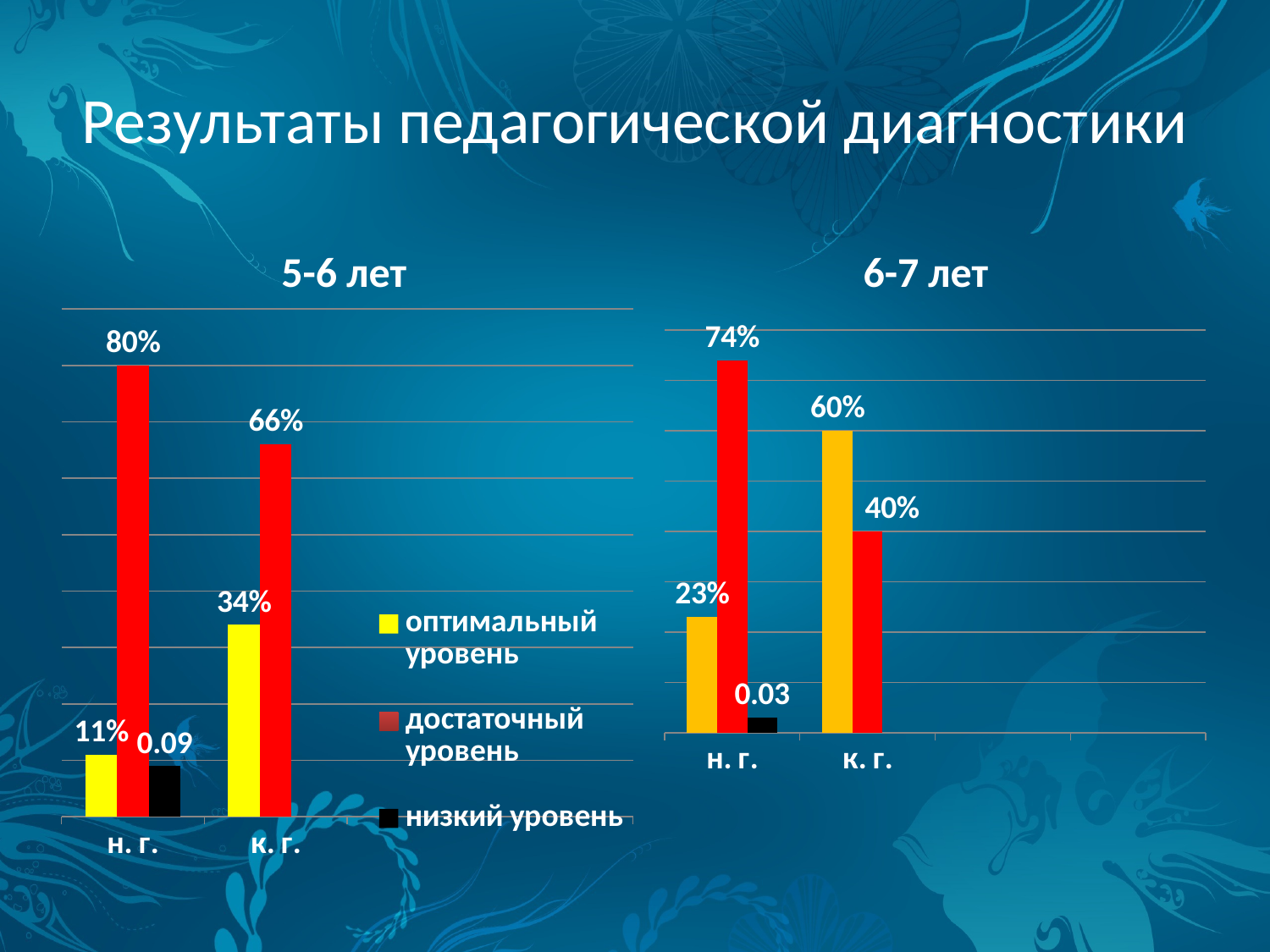
In the "6-7 лет" chart, what is the value of низкий уровень for н. г.? 0.03 In the "6-7 лет" chart, what is the value of достаточный уровень for к. г.? 40% In the "6-7 лет" chart, what is the value of оптимальный уровень for к. г.? 60% In the "5-6 лет" chart, what is the difference between достаточный уровень for н. г. and for к. г.? 14% How many series does the legend list? 3 In the "5-6 лет" chart, what is the value of низкий уровень for н. г.? 0.09 In the "5-6 лет" chart, which category has the highest value for достаточный уровень? н. г. In the "5-6 лет" chart, what is the value of оптимальный уровень for к. г.? 34% What kind of chart is the "6-7 лет" chart? bar chart In the "6-7 лет" chart, which category has the lowest value for оптимальный уровень? н. г. In the "6-7 лет" chart, which is larger for к. г.: оптимальный уровень or достаточный уровень? оптимальный уровень In the "5-6 лет" chart, what is the value of достаточный уровень for н. г.? 80%